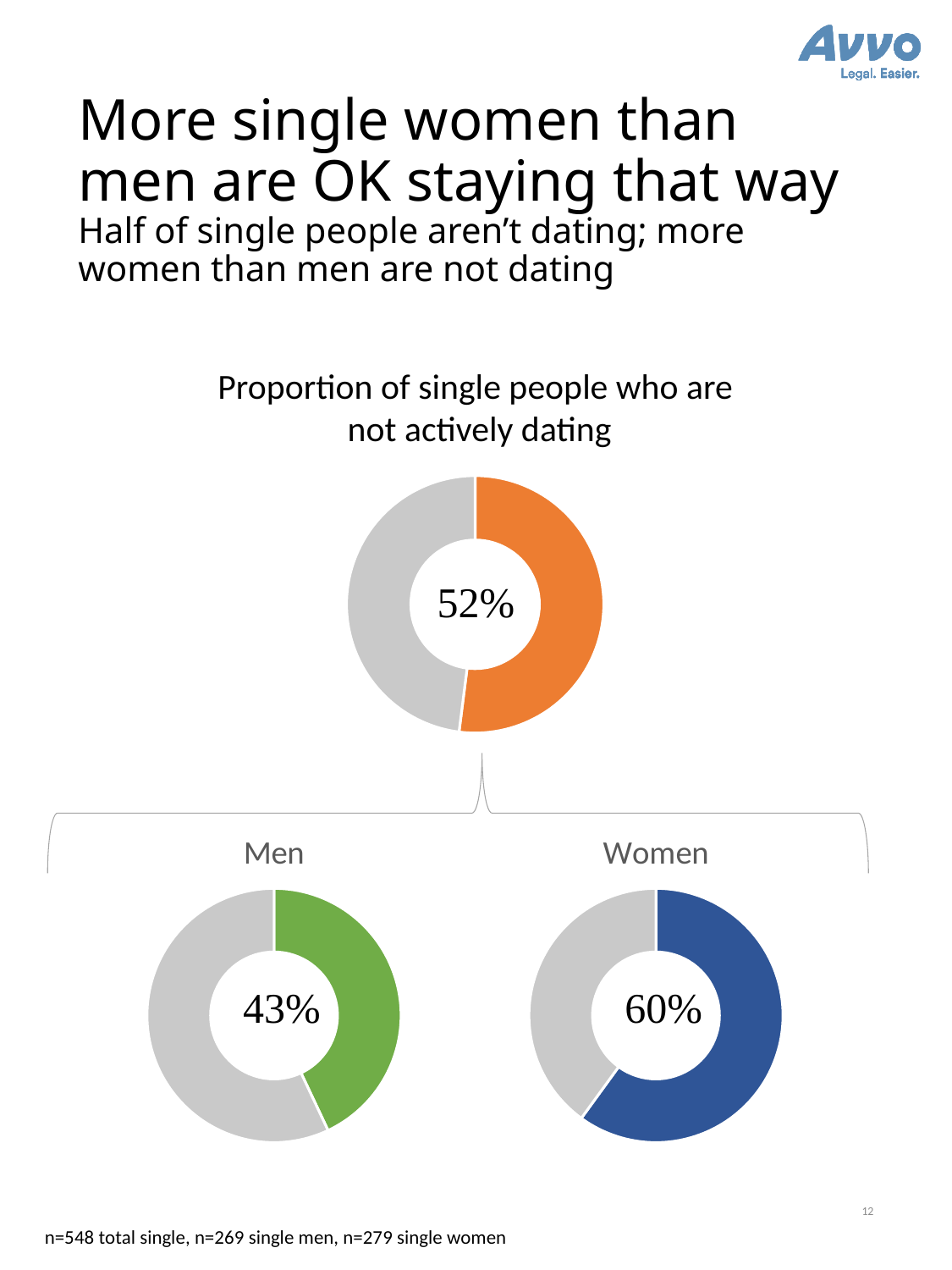
What is the difference between the percentage in the 'Women' donut chart and the percentage in the 'Men' donut chart? 17% What type of chart is used to show the proportion of single people who are not actively dating? Donut (pie) chart What is the difference between the percentage in the top overall donut chart and the percentage in the 'Men' donut chart? 9% What is the title of the top chart on the slide? Proportion of single people who are not actively dating What colour is the highlighted segment in the 'Women' donut chart? Blue Comparing the 'Men' and 'Women' donut charts, which group has the lower proportion not actively dating? Men What is the difference between the percentage in the 'Women' donut chart and the percentage in the top overall donut chart? 8% In the top chart titled 'Proportion of single people who are not actively dating', what percentage is shown in the centre of the donut? 52% In the 'Men' donut chart at the bottom left, what percentage is shown? 43% How many donut charts are shown on the slide? 3 Comparing the 'Men' and 'Women' donut charts, which group has the higher proportion not actively dating? Women In the 'Women' donut chart at the bottom right, what percentage is shown? 60%